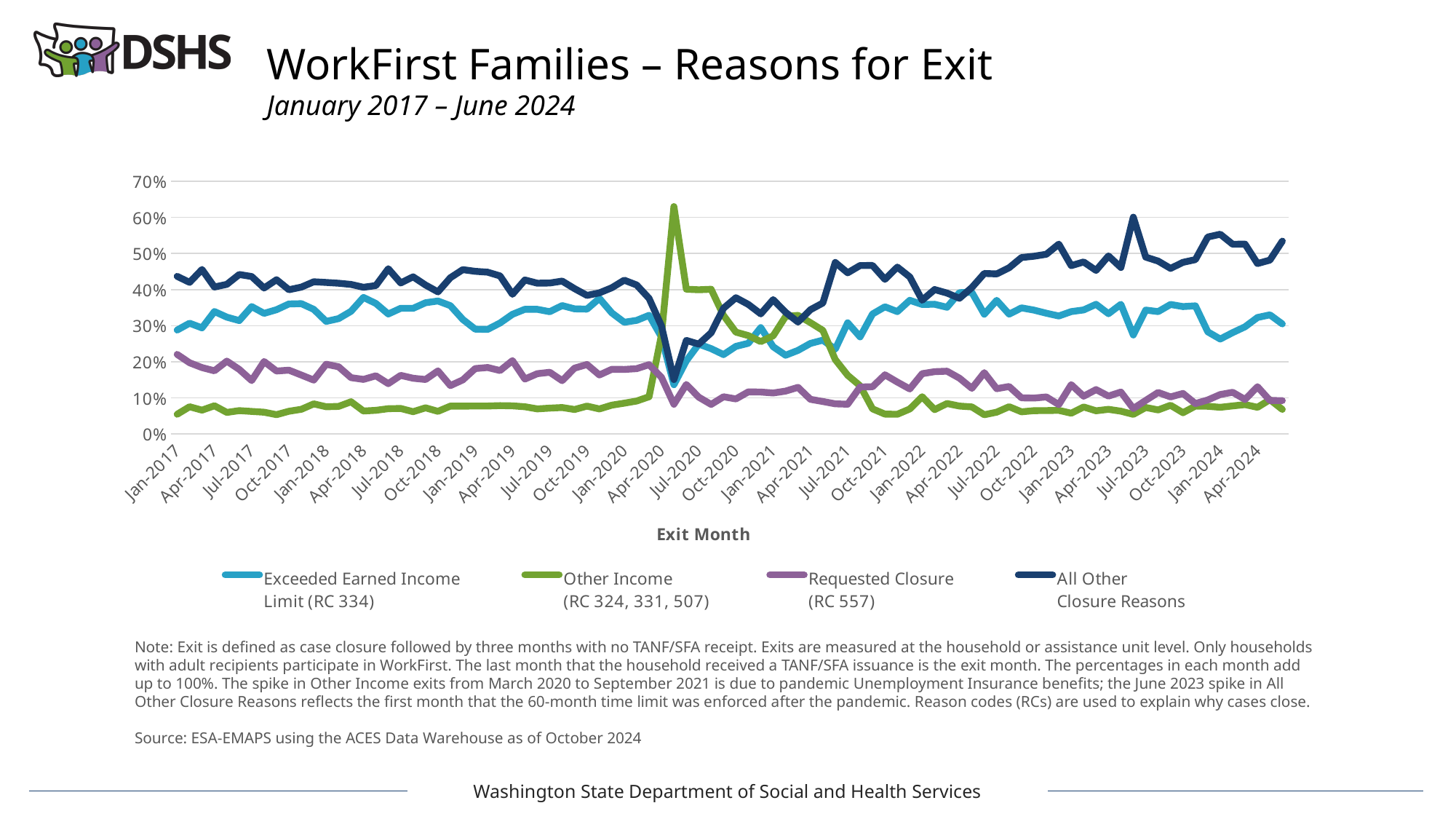
Is the value of the Requested Closure (RC 557) line at Jan-2017 greater or less than 30%? less What is the title of the chart on the slide? WorkFirst Families – Reasons for Exit Is the value of the Other Income (RC 324, 331, 507) line at Jan-2017 greater or less than 10%? less Does the Requested Closure (RC 557) line overall rise or fall from Jan-2017 to Apr-2024? fall Which series has the highest value at the right end of the chart (mid-2024)? All Other Closure Reasons How many series does the legend list? 4 What is the label of the x axis? Exit Month At Jan-2017, which is larger: All Other Closure Reasons or Exceeded Earned Income Limit (RC 334)? All Other Closure Reasons Is the value of the All Other Closure Reasons line at Jan-2024 greater or less than 50%? greater Which series has the lowest value at Jan-2017? Other Income (RC 324, 331, 507) What kind of chart is shown on the slide? line chart